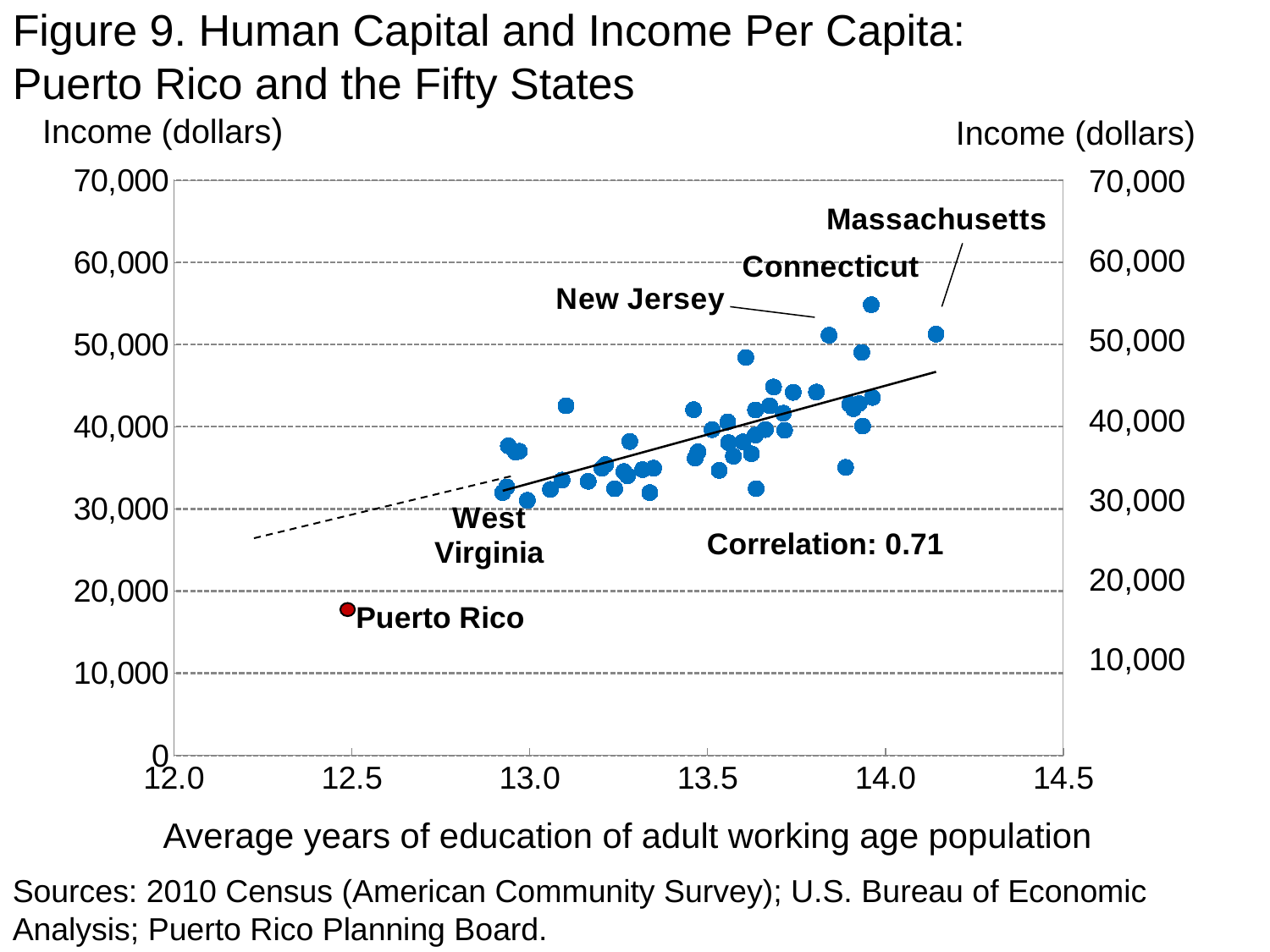
Is the average years of education for Puerto Rico greater or less than 13.0? less What kind of chart is shown on the slide? Scatter plot Is the income value for West Virginia greater or less than 40,000? less Among the labeled points, which has the highest income? Connecticut Which has the higher income, Puerto Rico or West Virginia? West Virginia Is the average years of education for Massachusetts greater or less than 14.0? greater What is the label of the x axis? Average years of education of adult working age population As average years of education increases along the x axis, does income generally rise or fall? Rise What correlation value is printed on the chart? 0.71 Among the labeled points, which has the lowest income? Puerto Rico